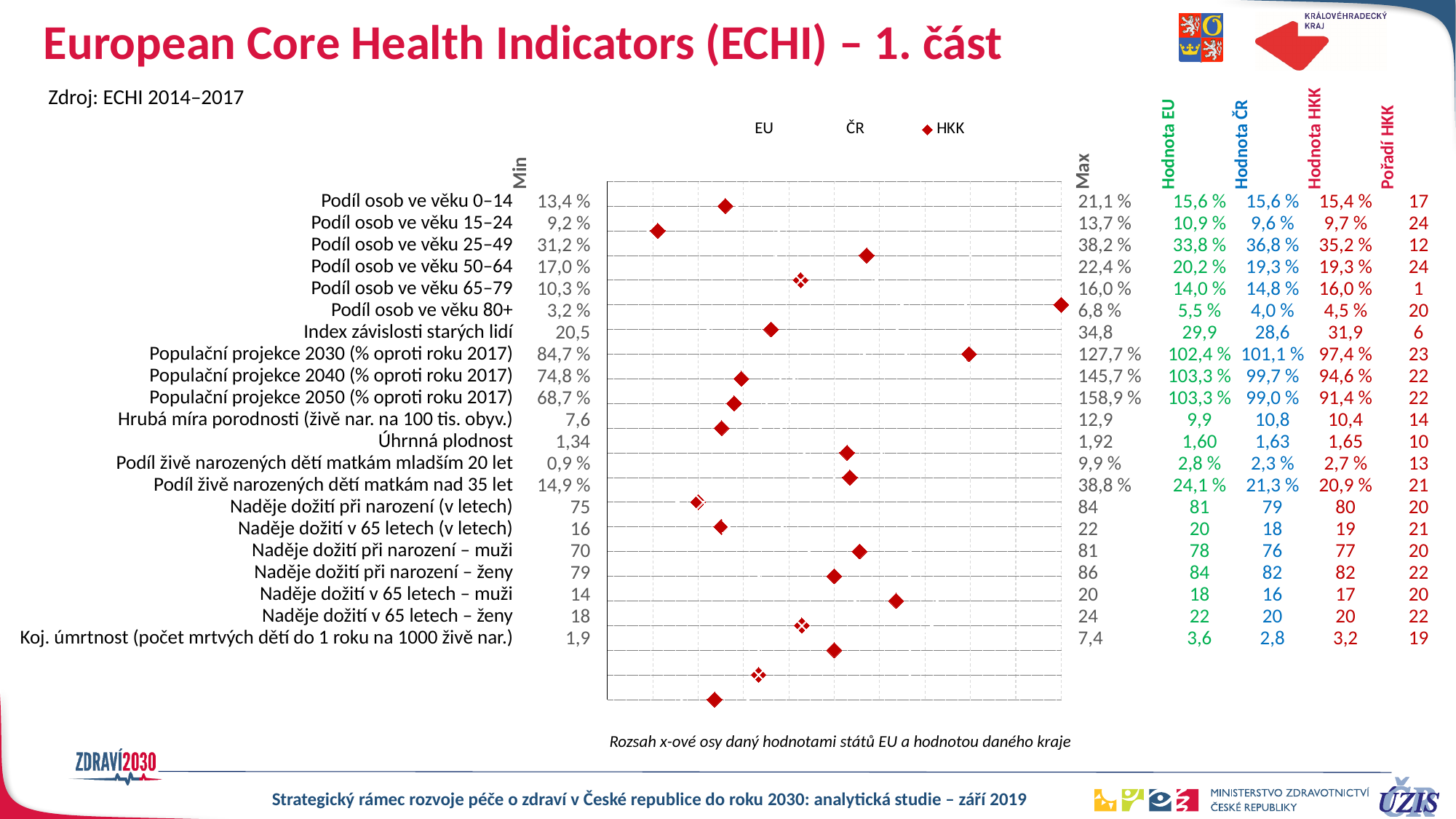
What is the Min value for "Koj. úmrtnost (počet mrtvých dětí do 1 roku na 1000 živě nar.)"? 1,9 What is the difference between the Max and Min values for "Naděje dožití při narození (v letech)"? 9 What kind of chart is shown on the slide? Scatter (dot) chart How many series does the chart legend list? 3 Which indicator has a Pořadí HKK (rank) of 1? Podíl osob ve věku 65–79 What is the Max value for "Populační projekce 2050 (% oproti roku 2017)"? 158,9 % What is the difference between the Hodnota EU and Hodnota HKK values for "Naděje dožití v 65 letech – ženy"? 2 What is the Hodnota HKK value for "Podíl osob ve věku 65–79"? 16,0 % What is the Pořadí HKK (rank) for "Index závislosti starých lidí"? 6 What is the Hodnota EU value for "Úhrnná plodnost"? 1,60 For "Podíl osob ve věku 25–49", which is larger: the Hodnota ČR value or the Hodnota HKK value? Hodnota ČR How many indicators (rows) are plotted in the chart? 21